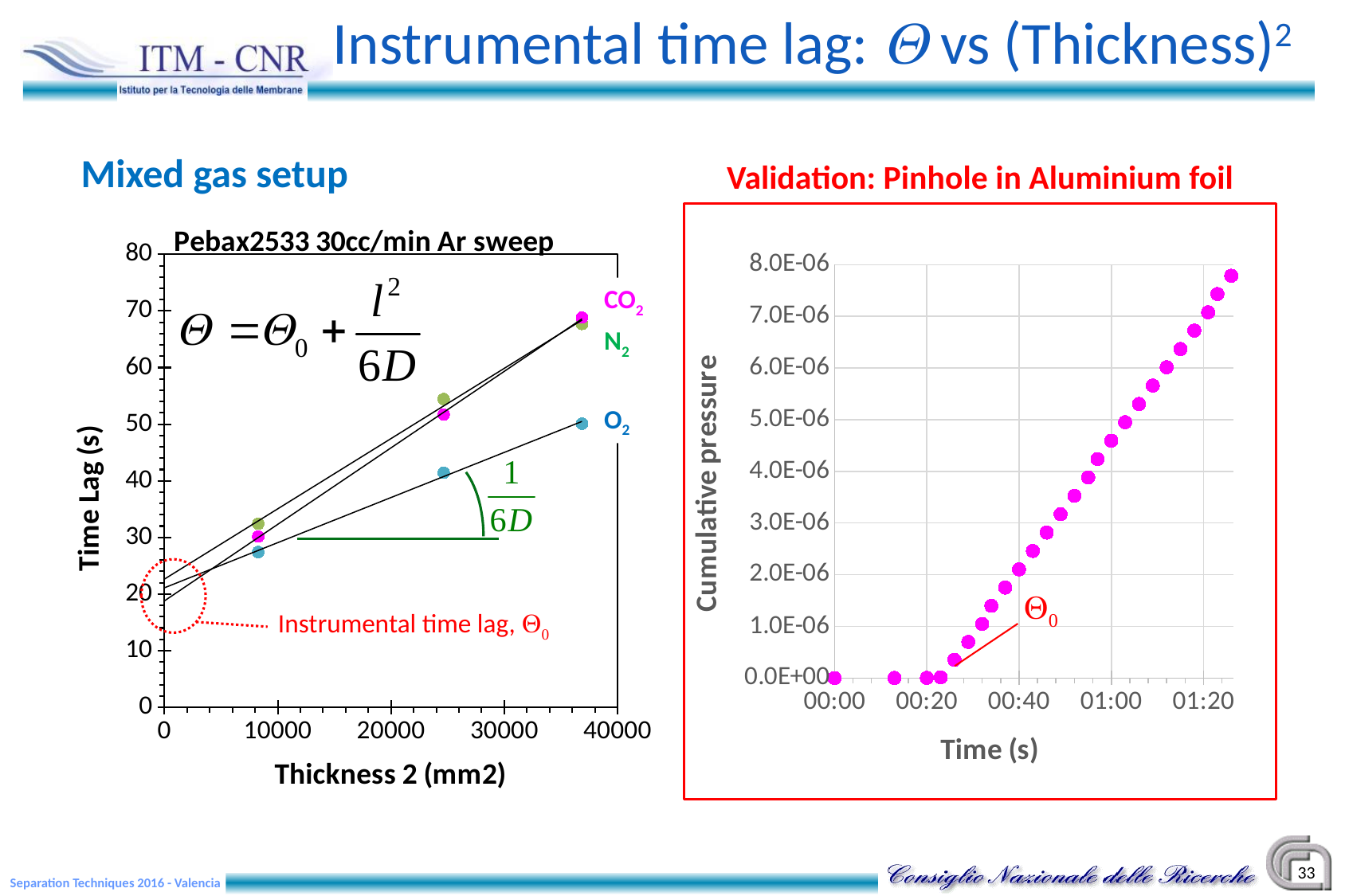
What is the y-axis title of the left chart 'Pebax2533 30cc/min Ar sweep'? Time Lag (s) On the right chart 'Validation: Pinhole in Aluminium foil', does the cumulative pressure rise or fall over time after 00:20? rise What kind of chart is the left chart titled 'Pebax2533 30cc/min Ar sweep'? scatter chart On the right chart 'Validation: Pinhole in Aluminium foil', is the cumulative pressure at the last time point greater or less than 7.0E-06? greater On the left chart 'Pebax2533 30cc/min Ar sweep', is the time lag for O2 at the smallest thickness squared (around 8000 mm2) greater or less than 30? less On the left chart 'Pebax2533 30cc/min Ar sweep', is the time lag for CO2 at the largest thickness squared greater or less than 60? greater On the left chart 'Pebax2533 30cc/min Ar sweep', which gas has the lowest time lag at the largest thickness squared (around 37000 mm2)? O2 On the left chart 'Pebax2533 30cc/min Ar sweep', does the time lag rise or fall as thickness squared increases? rise On the left chart 'Pebax2533 30cc/min Ar sweep', which is larger at the largest thickness squared: the time lag for CO2 or for O2? CO2 What is the x-axis title of the right chart 'Validation: Pinhole in Aluminium foil'? Time (s) How many gas series are labelled on the left chart 'Pebax2533 30cc/min Ar sweep'? 3